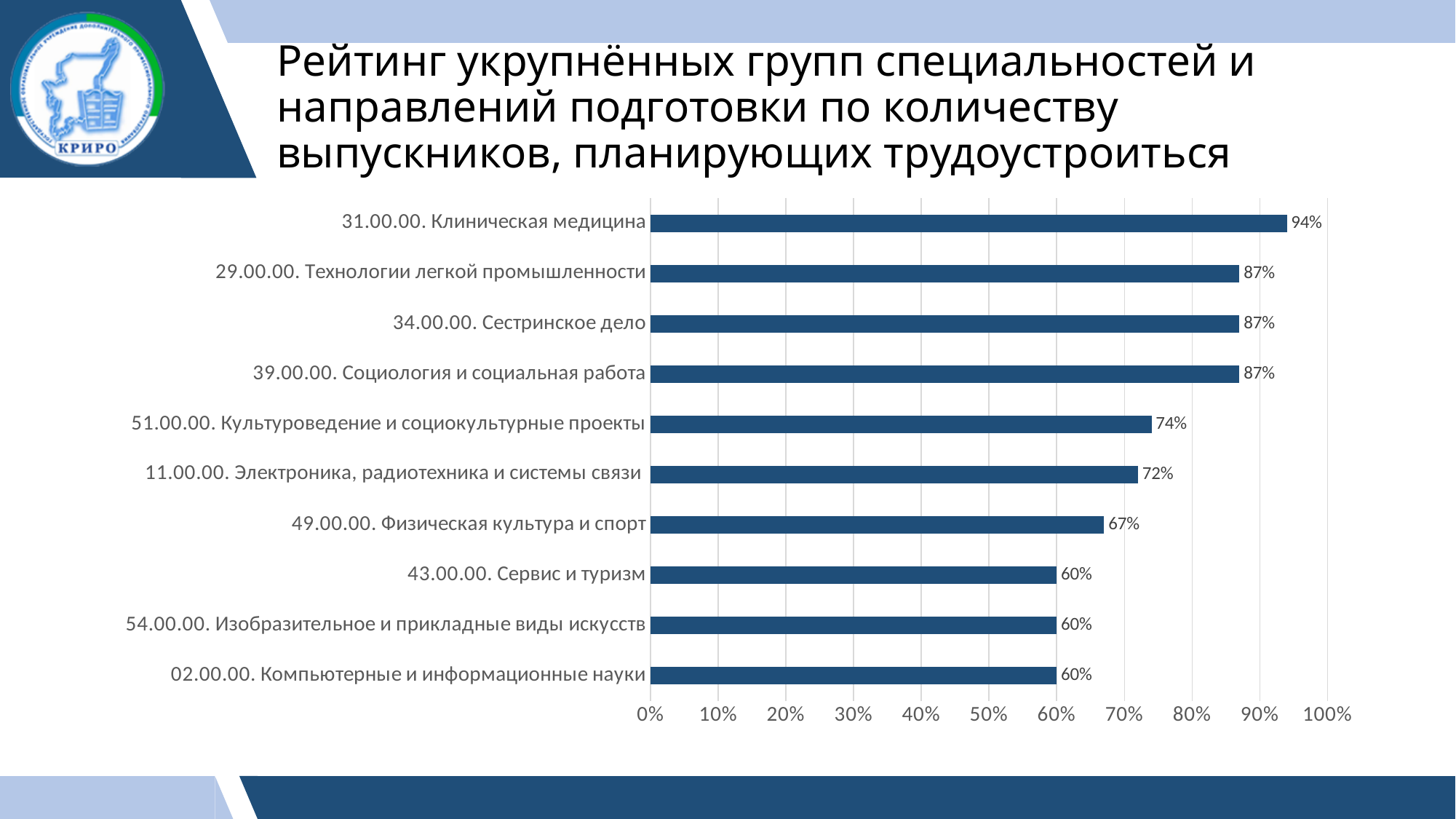
What is the difference between the values for 34.00.00. Сестринское дело and 43.00.00. Сервис и туризм? 27% What is the value for 31.00.00. Клиническая медицина? 94% Is the value for 29.00.00. Технологии легкой промышленности greater or less than 80%? greater What is the maximum value shown on the horizontal axis? 100% What is the difference between the values for 31.00.00. Клиническая медицина and 49.00.00. Физическая культура и спорт? 27% Which category has the highest value? 31.00.00. Клиническая медицина What kind of chart is shown on the slide? bar chart What is the value for 11.00.00. Электроника, радиотехника и системы связи? 72% How many categories are shown in the chart? 10 What is the value for 51.00.00. Культуроведение и социокультурные проекты? 74% Which is larger: the value for 51.00.00. Культуроведение и социокультурные проекты or the value for 49.00.00. Физическая культура и спорт? 51.00.00. Культуроведение и социокультурные проекты What is the value for 49.00.00. Физическая культура и спорт? 67%